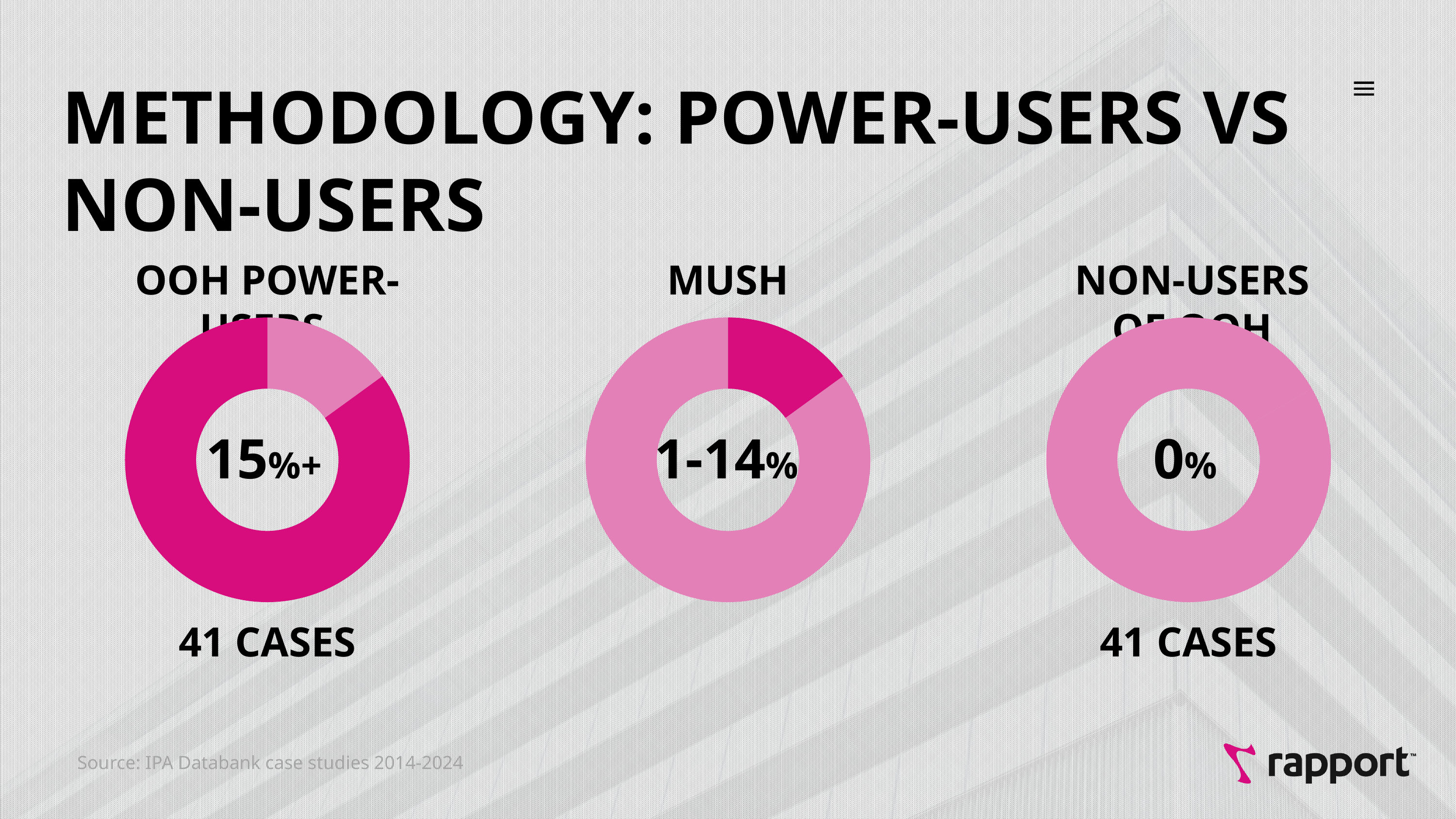
Which of the three donut charts has the largest dark pink segment? OOH POWER-USERS How many cases are listed under the NON-USERS OF OOH donut chart? 41 CASES How many donut charts are shown on the slide? 3 What label is printed in the centre of the MUSH donut chart? 1-14% What kind of chart is used for the OOH POWER-USERS group on the slide? Donut (pie) chart Is the dark pink segment larger in the OOH POWER-USERS donut chart or in the MUSH donut chart? OOH POWER-USERS What label is printed in the centre of the OOH POWER-USERS donut chart? 15%+ Which of the three donut charts has no dark pink segment at all? NON-USERS OF OOH What is the title of the slide containing the three donut charts? METHODOLOGY: POWER-USERS VS NON-USERS How many cases are listed under the OOH POWER-USERS donut chart? 41 CASES What label is printed in the centre of the NON-USERS OF OOH donut chart? 0% What source is cited at the bottom of the slide for the donut charts? IPA Databank case studies 2014-2024